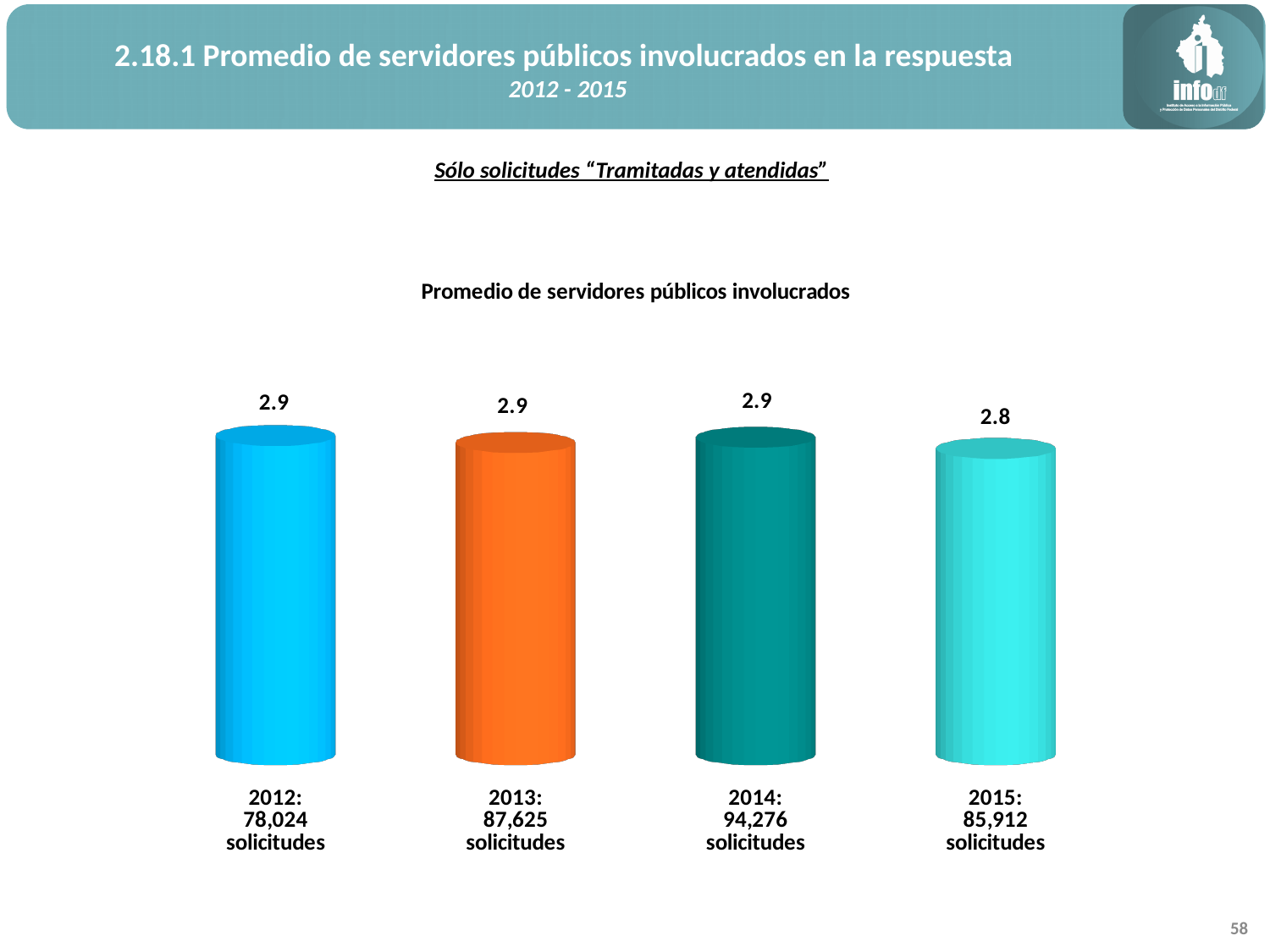
Which year has the lowest average number of public servants involved? 2015 What is the average number of public servants involved for 2015? 2.8 What is the average number of public servants involved for 2014? 2.9 What is the title of the chart? Promedio de servidores públicos involucrados Which is larger, the average for 2012 or the average for 2015? 2012 What colour is the bar for 2013? Orange How many solicitudes are listed under the 2014 bar? 94,276 solicitudes How many years (categories) are shown in the chart? 4 How many solicitudes are listed under the 2012 bar? 78,024 solicitudes What is the difference between the average for 2013 and the average for 2015? 0.1 What kind of chart is shown on the slide? Bar chart What is the average number of public servants involved (Promedio de servidores públicos involucrados) for 2012? 2.9